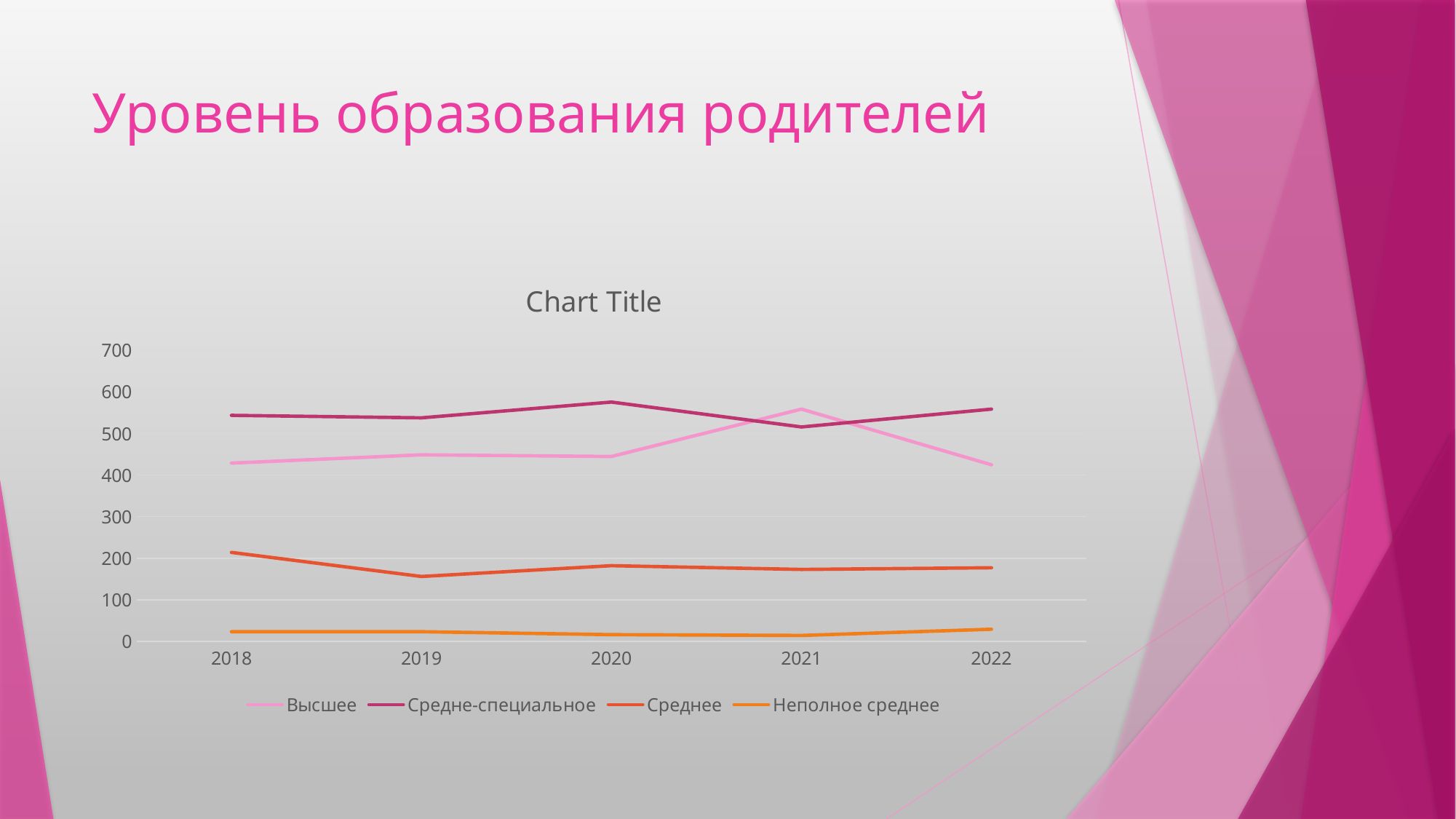
What is the title shown above the chart? Chart Title Is the value for Средне-специальное in 2020 greater or less than 500? greater In 2021, which is larger: Высшее or Средне-специальное? Высшее In 2018, which is larger: Среднее or Высшее? Высшее What kind of chart is shown on the slide? line chart How many years are shown on the x axis? 5 Is the value for Высшее in 2021 greater or less than 500? greater Is the value for Неполное среднее in 2020 greater or less than 100? less How many series does the legend list? 4 Which series has the lowest values across all years? Неполное среднее In which year does the Высшее series reach its highest value? 2021